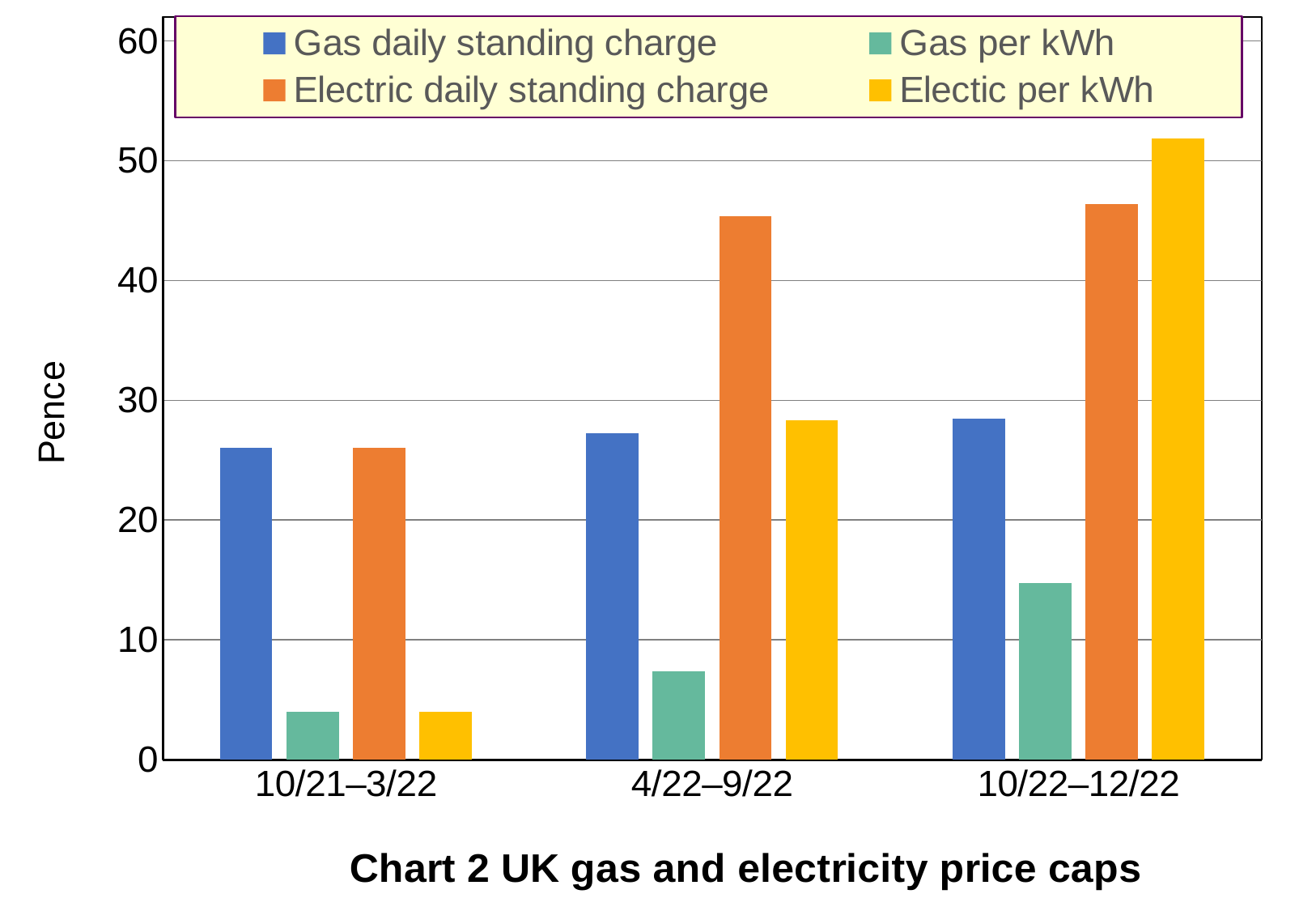
Which series has the tallest bar in the 10/22–12/22 period? Electic per kWh What kind of chart is shown on the slide? bar chart What is the label on the vertical axis? Pence Is the value for Electic per kWh in 10/22–12/22 greater or less than 50? greater In the 4/22–9/22 period, which is larger: Electric daily standing charge or Gas daily standing charge? Electric daily standing charge How many time periods are shown on the x axis? 3 Is the value for Electric daily standing charge in 4/22–9/22 greater or less than 40? greater Is the value for Gas per kWh in 4/22–9/22 greater or less than 10? less Which series has the lowest bar in the 4/22–9/22 period? Gas per kWh What is the title of the chart? Chart 2 UK gas and electricity price caps How many series does the legend list? 4 Does the Electic per kWh value rise or fall across the three periods from 10/21–3/22 to 10/22–12/22? rise